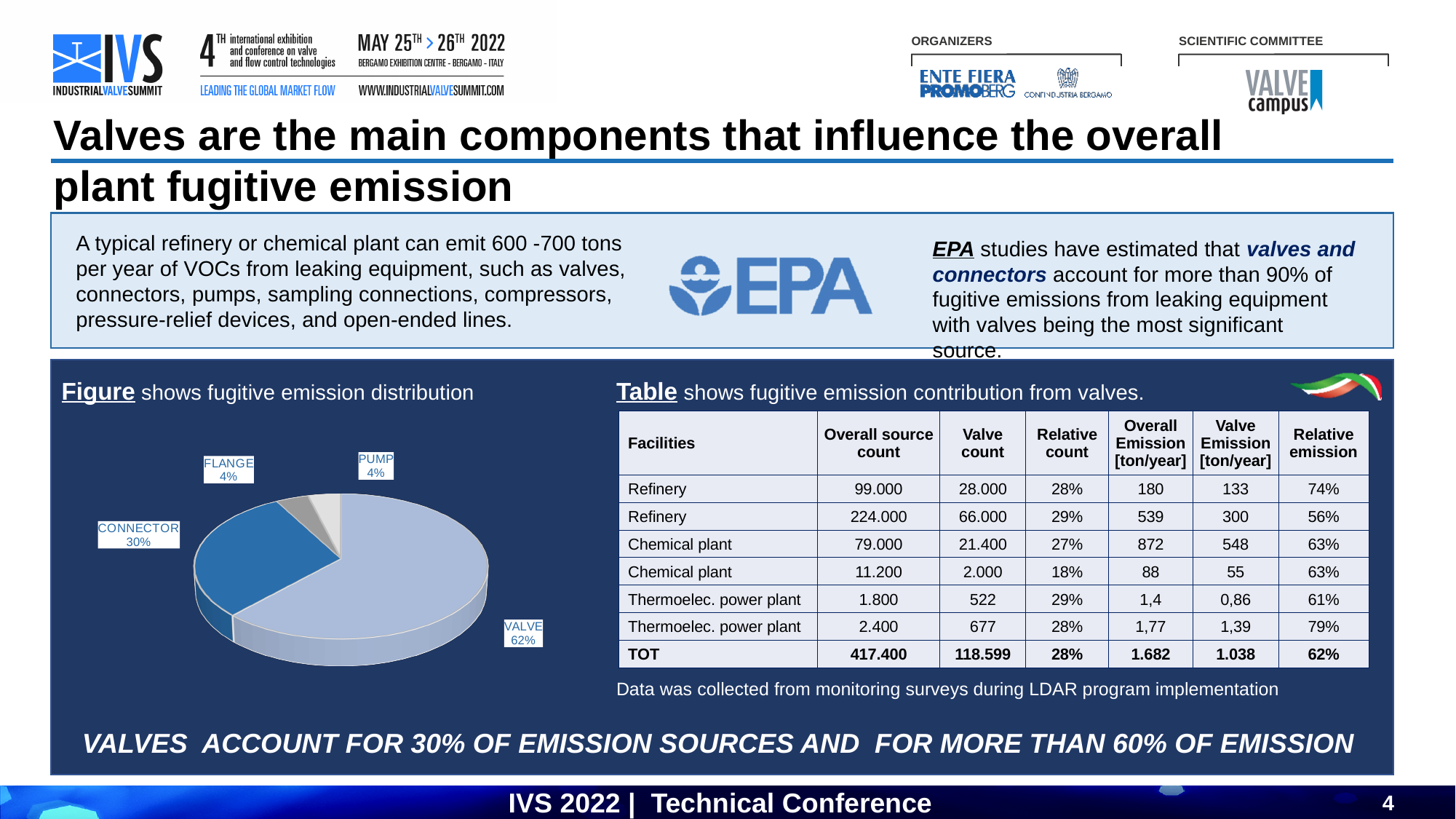
According to the caption, what does the figure show? fugitive emission distribution What is the combined share of the FLANGE and PUMP slices? 8% What percentage is shown for FLANGE in the pie chart? 4% How many slices does the pie chart have? 4 Is the VALVE slice greater or less than 50% of the pie? greater What kind of chart is shown on the slide? pie chart What share of fugitive emission sources does VALVE account for in the pie chart? 62% What is the difference in percentage points between the VALVE and CONNECTOR slices? 32% Which slice is larger in the pie chart, CONNECTOR or FLANGE? CONNECTOR Which category has the largest slice in the pie chart? VALVE What percentage is shown for PUMP in the pie chart? 4% What share of the pie chart is labelled CONNECTOR? 30%